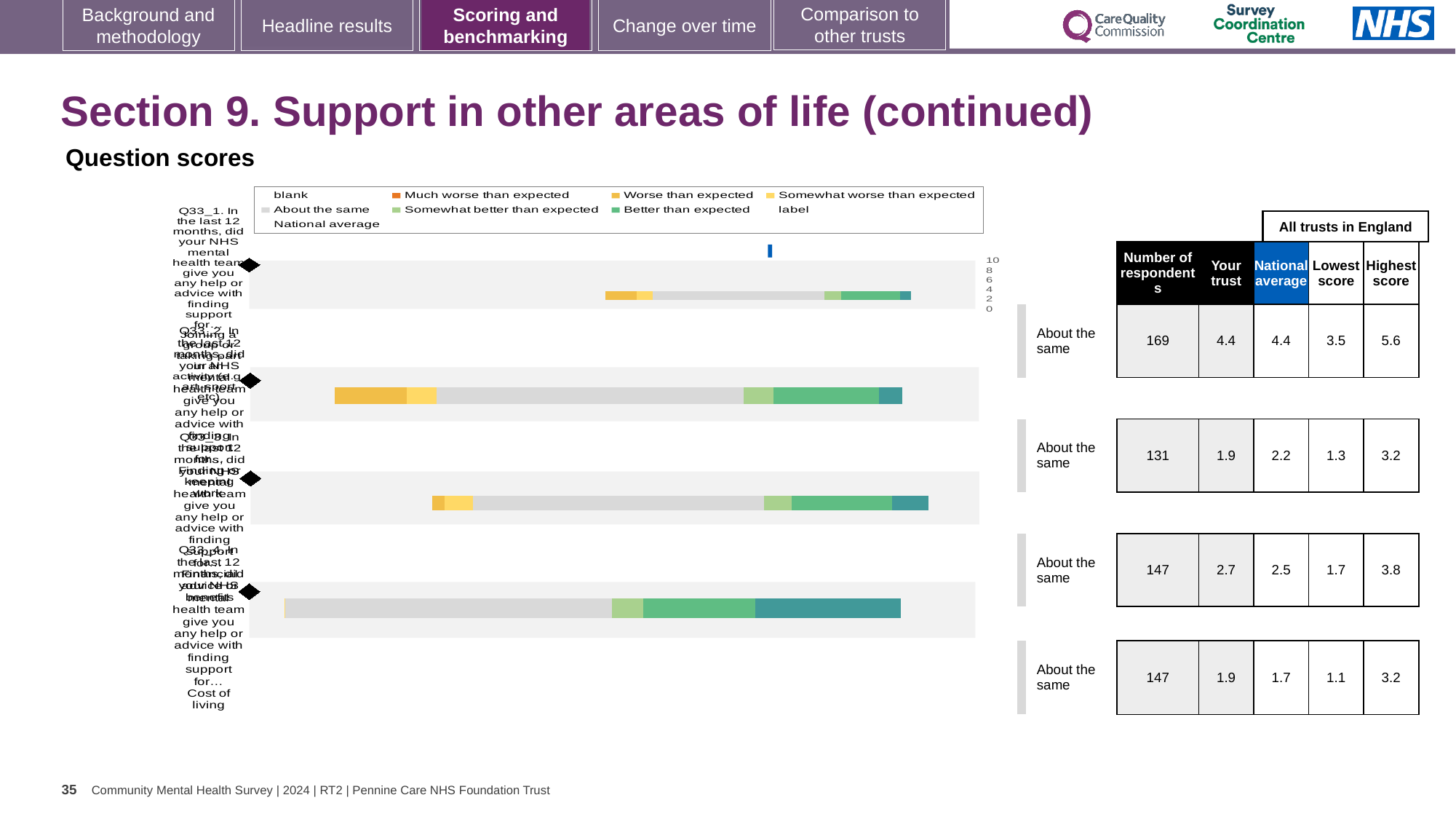
How many question bars are plotted in the chart? 4 How many entries does the chart legend list? 9 Which question bar has the longest 'Worse than expected' segment? Q33_2 Which legend entry is shown in dark orange? Much worse than expected Which legend entry is shown in light grey? About the same What kind of chart is shown on the slide? Bar chart Is the 'Better than expected' segment longer for Q33_4 or Q33_1? Q33_4